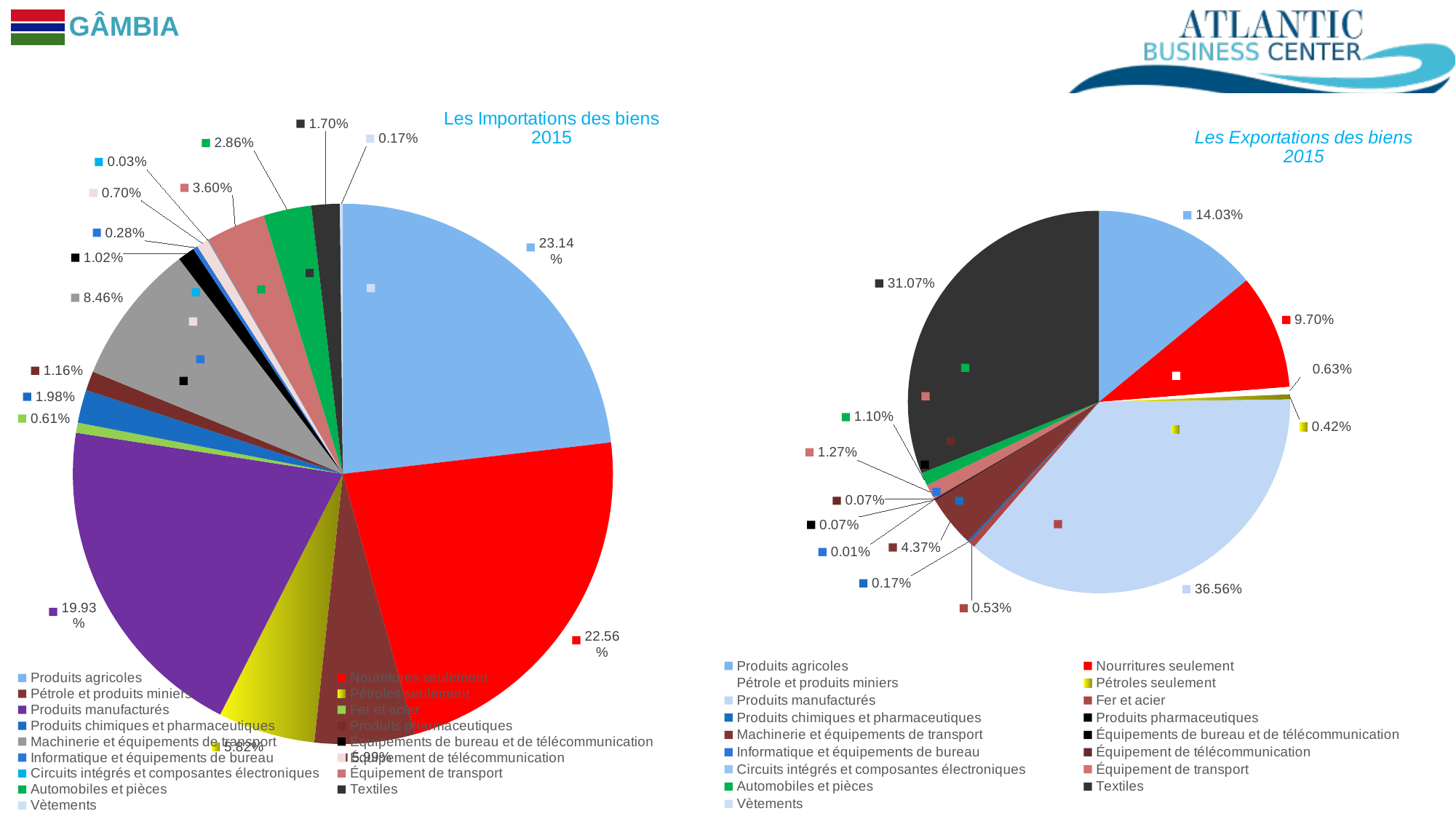
In the 'Les Importations des biens 2015' chart, what share do Produits agricoles have? 23.14% In the 'Les Exportations des biens 2015' chart, what share does Machinerie et équipements de transport have? 4.37% In the 'Les Exportations des biens 2015' chart, what share do Produits agricoles have? 14.03% In the 'Les Importations des biens 2015' chart, what share do Produits manufacturés have? 19.93% In the 'Les Importations des biens 2015' chart, which is larger: Produits agricoles or Nourritures seulement? Produits agricoles In the 'Les Exportations des biens 2015' chart, what share do Textiles have? 31.07% In the 'Les Exportations des biens 2015' chart, which category has the largest slice? Produits manufacturés In the 'Les Importations des biens 2015' chart, which category has the largest slice? Produits agricoles In the 'Les Exportations des biens 2015' chart, what is the difference between Produits manufacturés and Textiles? 5.49% What kind of chart is 'Les Importations des biens 2015'? Pie chart How many categories does the legend of the 'Les Exportations des biens 2015' chart list? 17 In the 'Les Importations des biens 2015' chart, what share does Nourritures seulement have? 22.56%